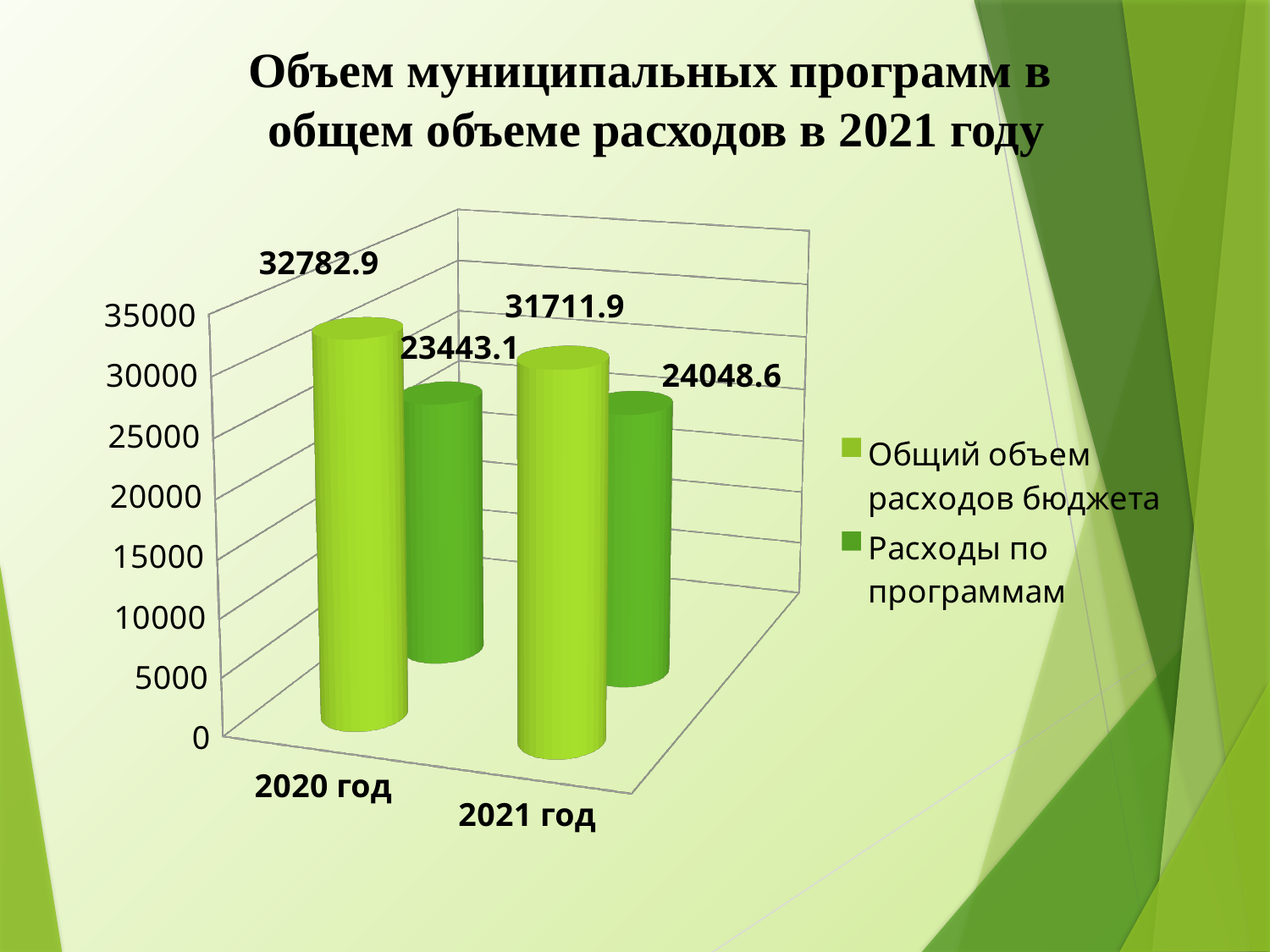
What is the difference between Общий объем расходов бюджета and Расходы по программам in 2020 год? 9339.8 What is the value of Общий объем расходов бюджета for 2021 год? 31711.9 What is the difference between Общий объем расходов бюджета and Расходы по программам in 2021 год? 7663.3 What is the value of Расходы по программам for 2021 год? 24048.6 Which year has the higher value for Общий объем расходов бюджета? 2020 год What kind of chart is shown on the slide? Bar chart How many series does the legend list? 2 Does Общий объем расходов бюджета rise or fall from 2020 год to 2021 год? Fall Which is larger: Расходы по программам in 2020 год or in 2021 год? 2021 год Which year has the lower value for Расходы по программам? 2020 год What is the value of Общий объем расходов бюджета for 2020 год? 32782.9 What is the value of Расходы по программам for 2020 год? 23443.1